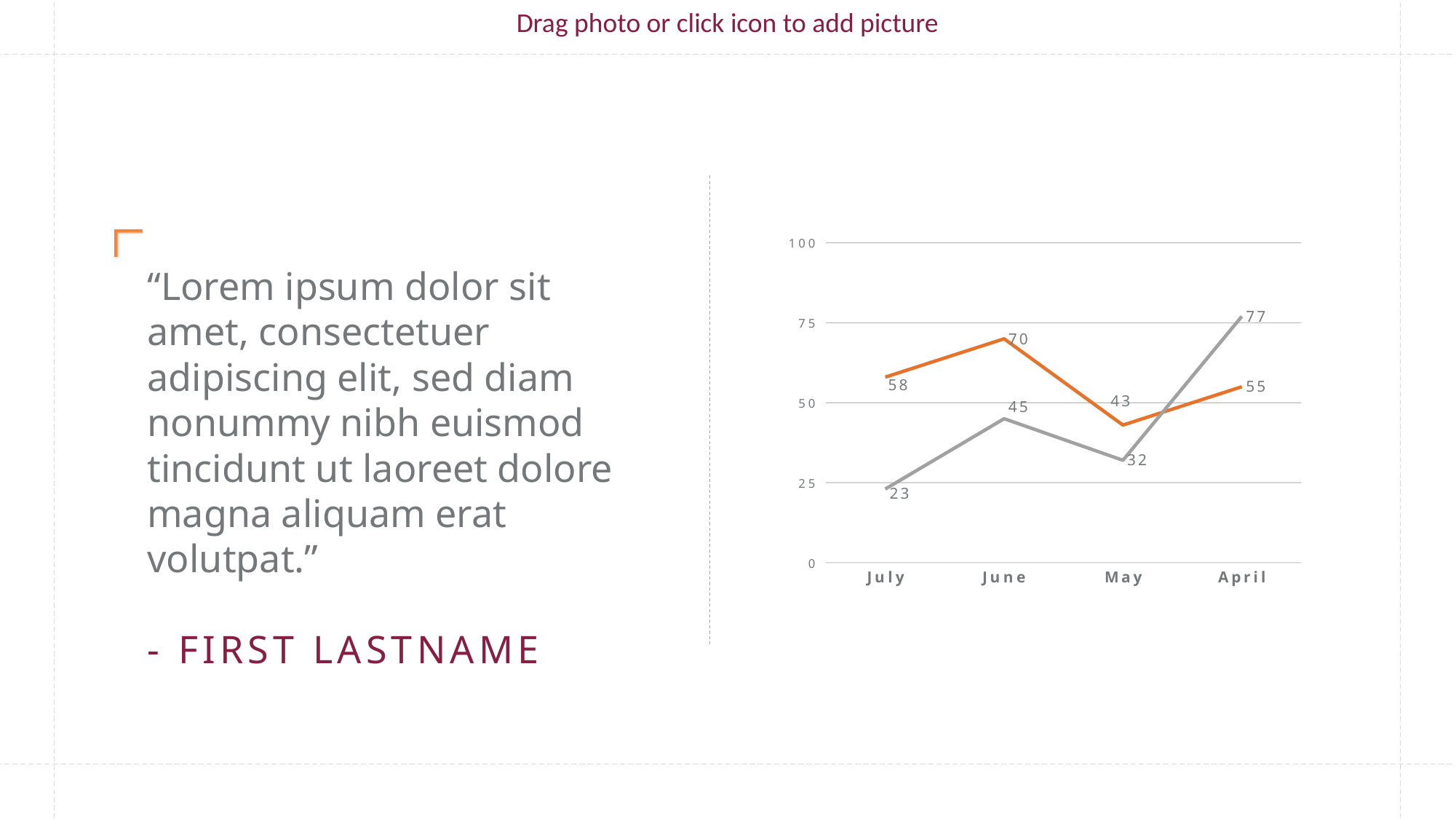
In which category does the gray line reach its highest value? April Is the gray line's value for May greater or less than 50? less What is the value of the gray line for July? 23 What is the difference between the orange line's value for July and the gray line's value for July? 35 How many categories are shown on the x axis of the chart? 4 Which line has the larger value for April, the orange line or the gray line? gray line What is the value of the orange line for June? 70 What is the value of the orange line for May? 43 What is the value of the gray line for April? 77 Does the gray line rise or fall from May to April? rise What type of chart is shown on the slide? line chart In which category does the orange line have its lowest value? May